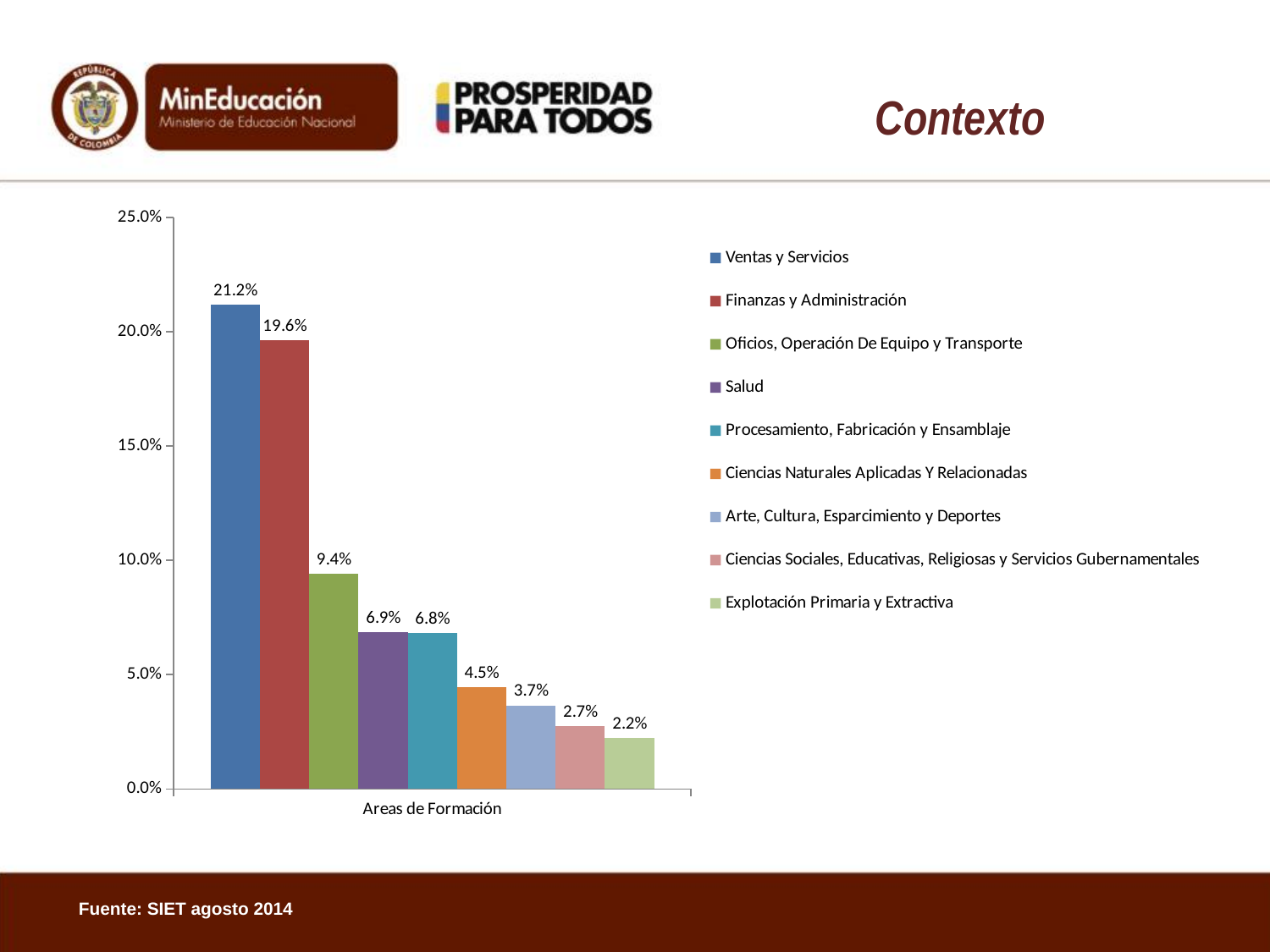
What is the value for Salud? 6.9% Is the value for Arte, Cultura, Esparcimiento y Deportes greater or less than 5.0%? less What is the value for Ventas y Servicios? 21.2% Which series has the highest value? Ventas y Servicios What is the label on the x axis of the chart? Areas de Formación Which is larger, Oficios, Operación De Equipo y Transporte or Ciencias Naturales Aplicadas Y Relacionadas? Oficios, Operación De Equipo y Transporte How many series does the legend list? 9 What is the value for Explotación Primaria y Extractiva? 2.2% What kind of chart is shown on the slide? bar chart What is the value for Finanzas y Administración? 19.6% Which series has the lowest value? Explotación Primaria y Extractiva What is the difference between Ventas y Servicios and Finanzas y Administración? 1.6%